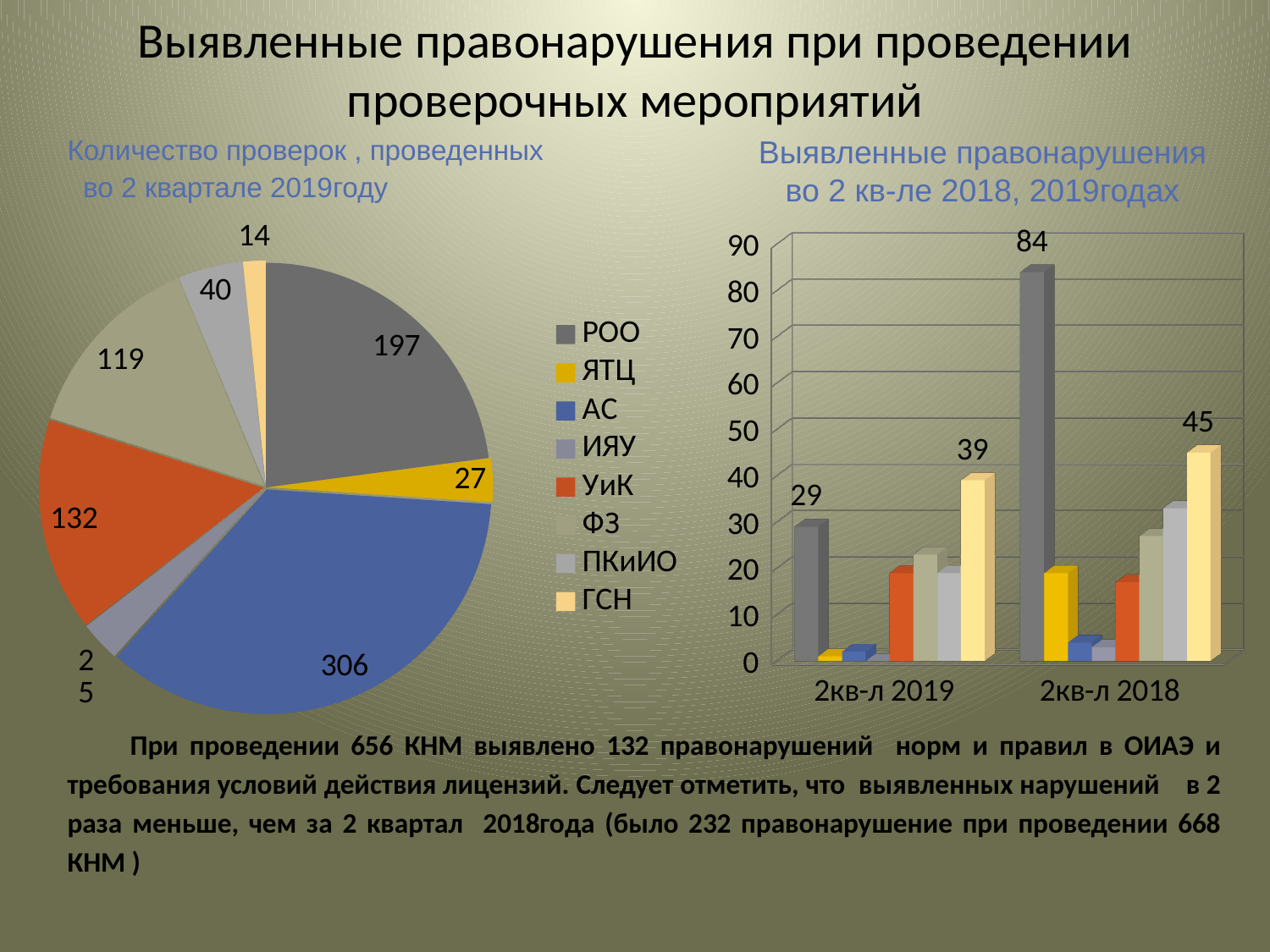
What kind of chart is the chart on the right titled 'Выявленные правонарушения во 2 кв-ле 2018, 2019годах'? bar chart In the pie chart on the left, which category has the largest slice? АС In the bar chart on the right, what is the value of the tallest bar in the 2кв-л 2018 group? 84 In the pie chart on the left, what is the difference between the values for РОО and ФЗ? 78 In the bar chart on the right, what is the difference between the dark grey bar in 2кв-л 2018 (84) and the dark grey bar in 2кв-л 2019 (29)? 55 How many groups are shown on the x axis of the bar chart on the right? 2 In the pie chart on the left, what is the value for АС? 306 In the bar chart on the right, what is the value of the light yellow bar in the 2кв-л 2019 group? 39 In the pie chart on the left, which category has the smallest slice? ГСН In the pie chart on the left, what is the value for УиК? 132 In the pie chart on the left, which is larger, УиК or ФЗ? УиК How many categories does the legend of the pie chart on the left list? 8